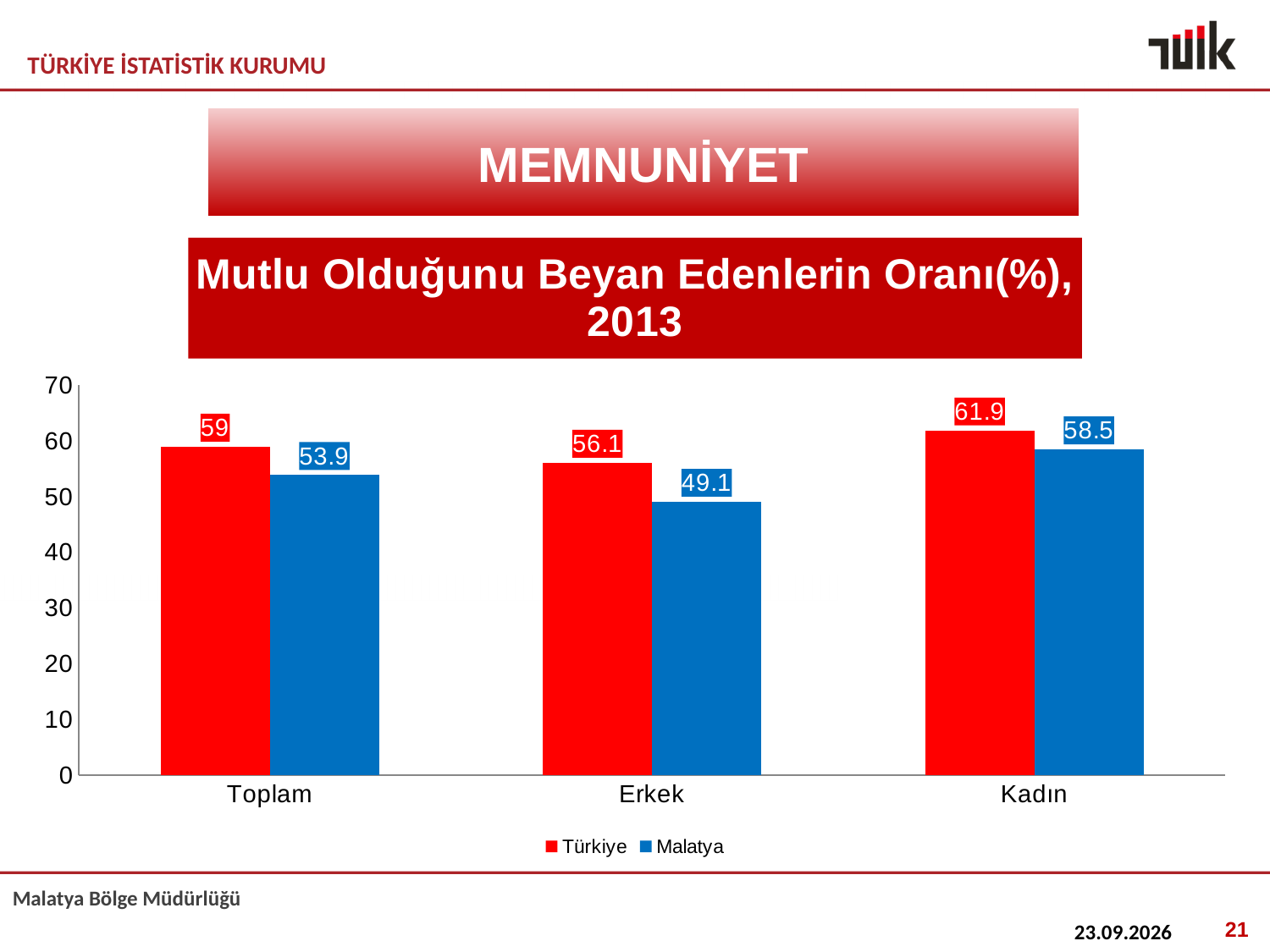
What is the value for Malatya in the Erkek category? 49.1 How many series does the legend list? 2 Which category has the lowest value for Malatya? Erkek What is the value for Malatya in the Kadın category? 58.5 What is the difference between the Türkiye and Malatya values in the Erkek category? 7 What is the difference between the Kadın and Erkek values for Malatya? 9.4 Which is larger in the Toplam category, Türkiye or Malatya? Türkiye Which category has the highest value for Türkiye? Kadın What is the value for Türkiye in the Toplam category? 59 What kind of chart is shown on the slide? bar chart Is the value for Malatya in the Erkek category greater or less than 50? less How many categories are shown on the x axis? 3